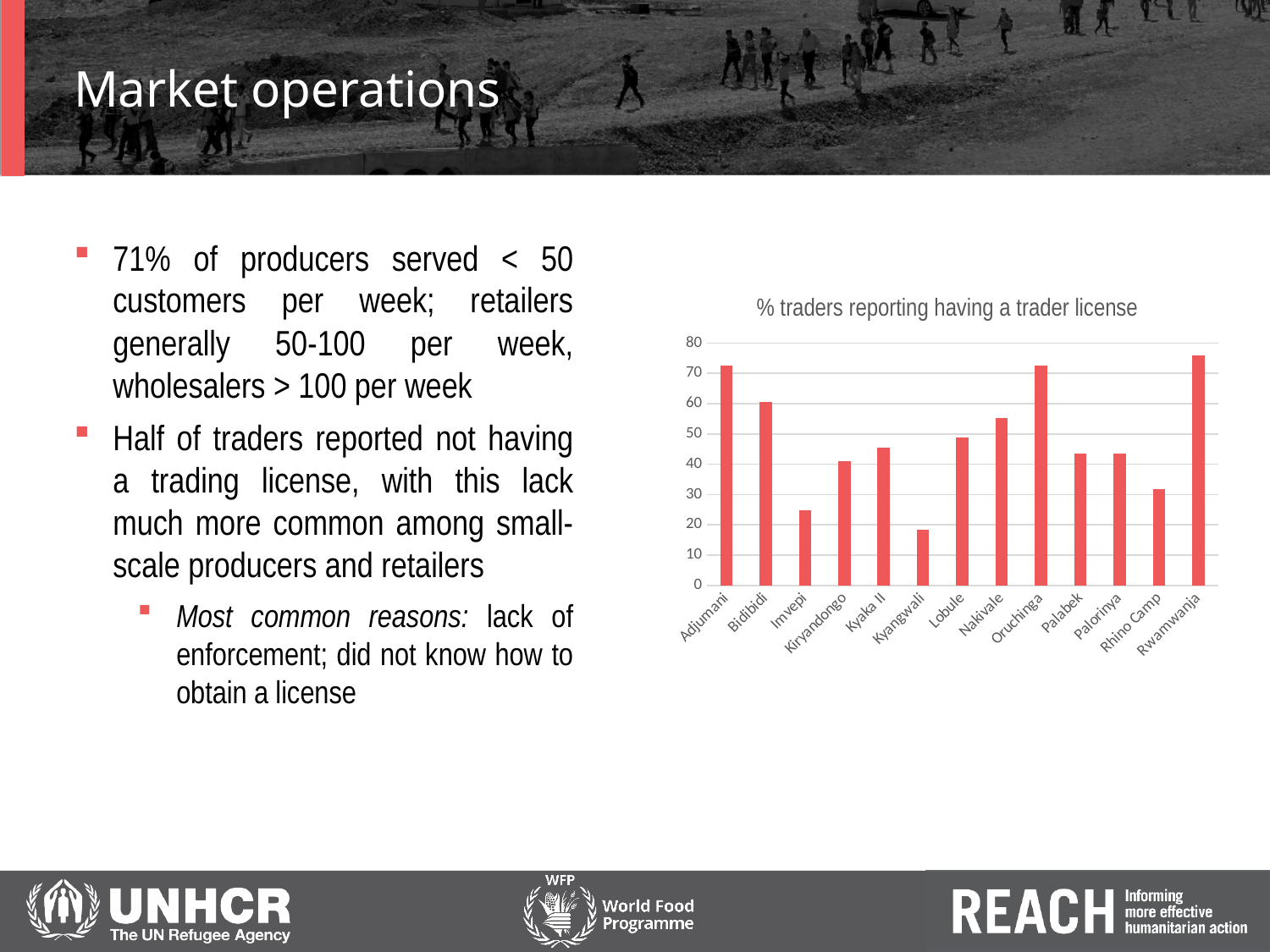
Which has a higher value, Imvepi or Rhino Camp? Rhino Camp Which settlement has the lowest percentage of traders reporting having a trader license? Kyangwali Which settlement has the highest percentage of traders reporting having a trader license? Rwamwanja What kind of chart is shown on the slide? bar chart What is the title of the chart? % traders reporting having a trader license Is the value for Nakivale greater or less than 50? greater Which has a higher value, Bidibidi or Nakivale? Bidibidi Is the value for Rhino Camp greater or less than 40? less Is the value for Rwamwanja greater or less than 70? greater How many settlements (categories) are shown on the x axis of the chart? 13